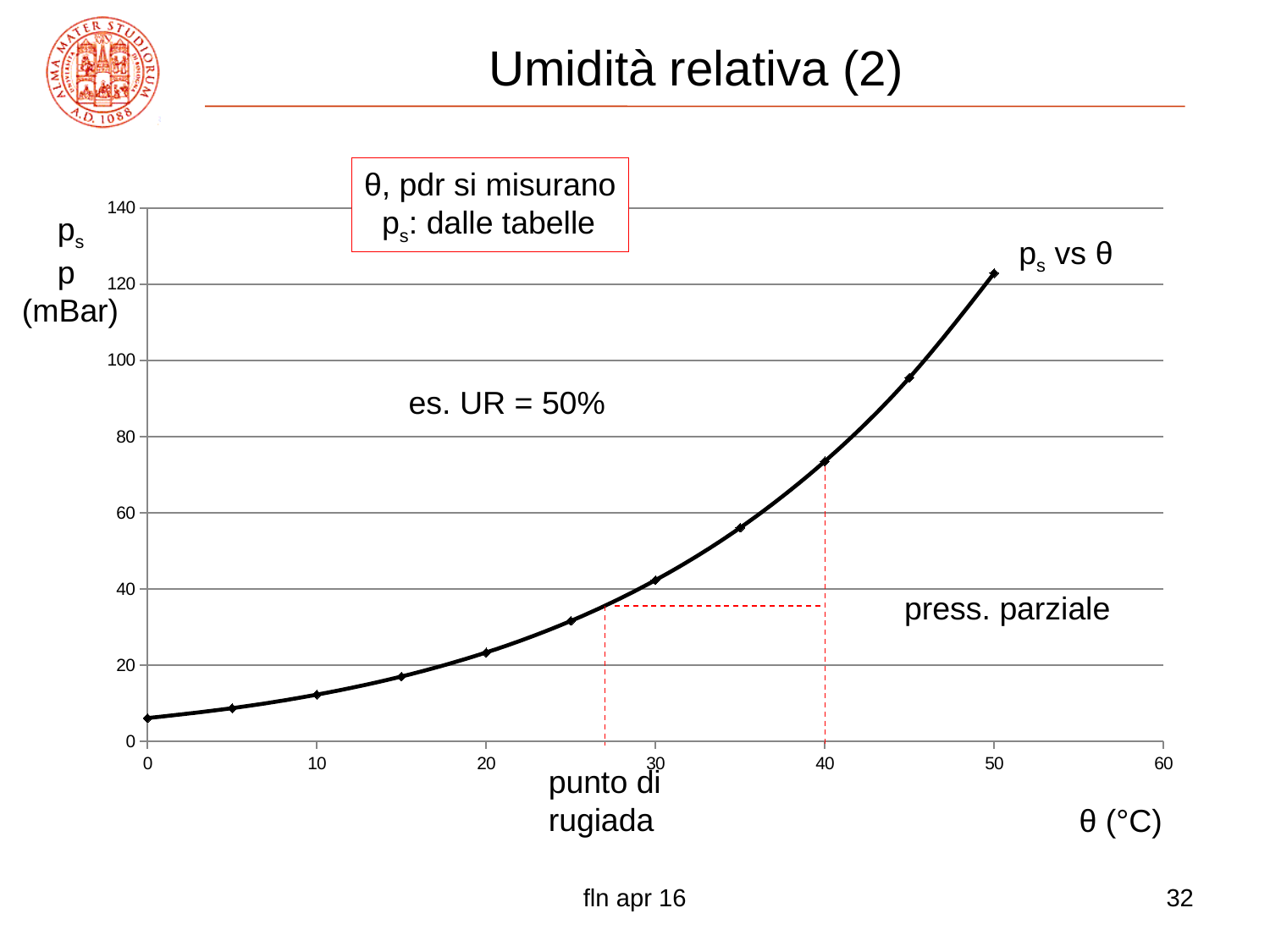
What unit is shown for the vertical axis of the chart? mBar Is the value of ps at θ = 10 greater or less than 20? less At which temperature θ is the plotted value of ps highest? 50 Is the value of ps at θ = 20 greater or less than 40? less Is the value of ps at θ = 40 greater or less than 60? greater Which is larger, the value of ps at θ = 30 or at θ = 45? θ = 45 How many data points are plotted on the ps vs θ curve? 11 Do the values of ps rise or fall as θ increases along the x axis? rise What kind of chart is shown on the slide? line chart At which temperature θ is the plotted value of ps lowest? 0